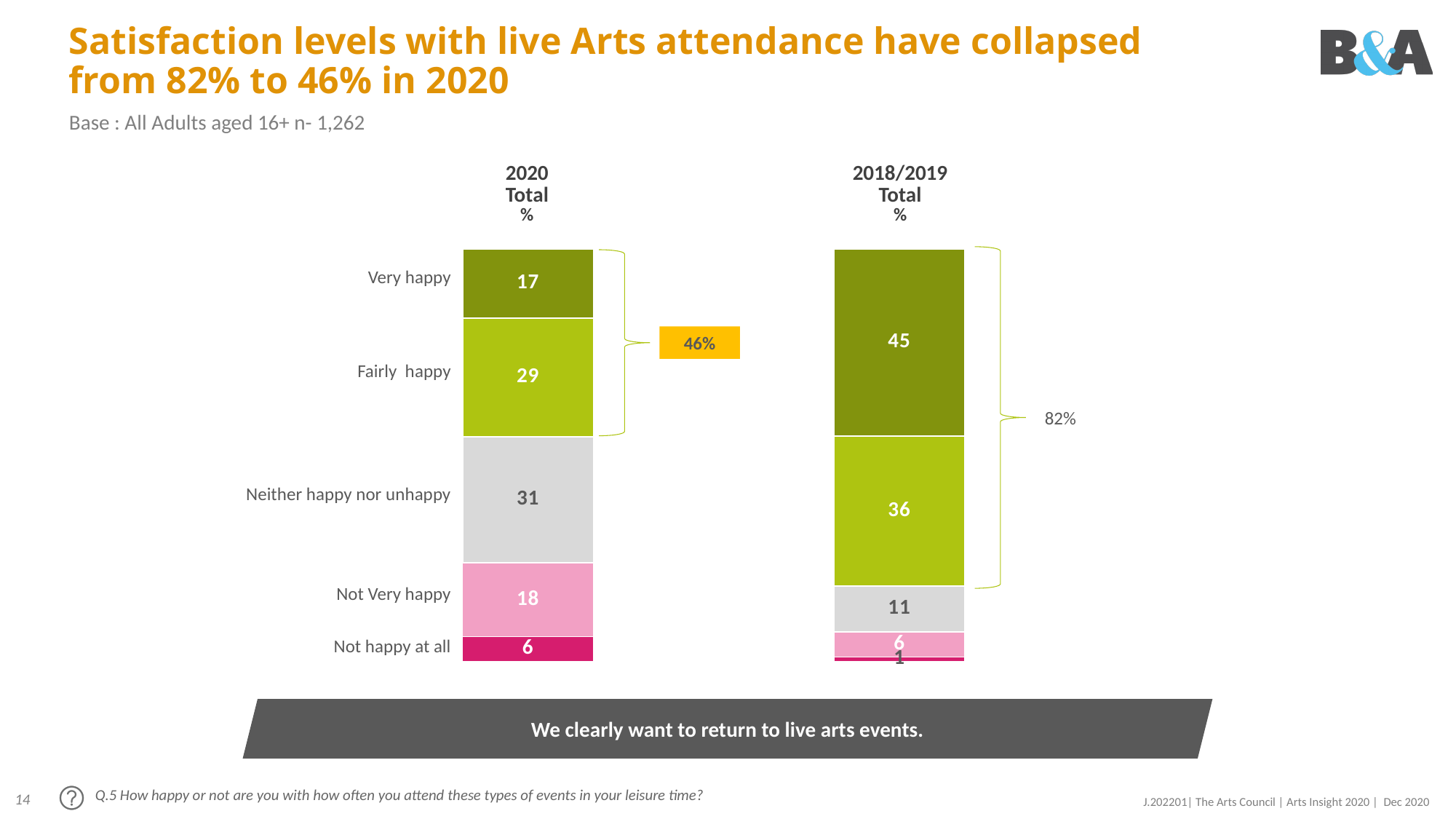
How many response categories are shown in each stacked bar? 5 What percentage of adults were 'Very happy' in 2020? 17 What percentage of adults were 'Fairly happy' in 2018/2019? 36 What is the value for 'Neither happy nor unhappy' in the 2020 bar? 31 What type of chart is shown on the slide? Stacked bar chart What is the combined 'Very happy' plus 'Fairly happy' share shown for 2018/2019? 82% Which is larger: 'Not Very happy' in 2020 or 'Not Very happy' in 2018/2019? 2020 What is the value for 'Not happy at all' in the 2018/2019 bar? 1 What is the combined 'Very happy' plus 'Fairly happy' share shown for 2020? 46% By how many percentage points did 'Very happy' fall from 2018/2019 to 2020? 28 Which response category has the smallest share in the 2020 bar? Not happy at all Which response category has the largest share in the 2018/2019 bar? Very happy